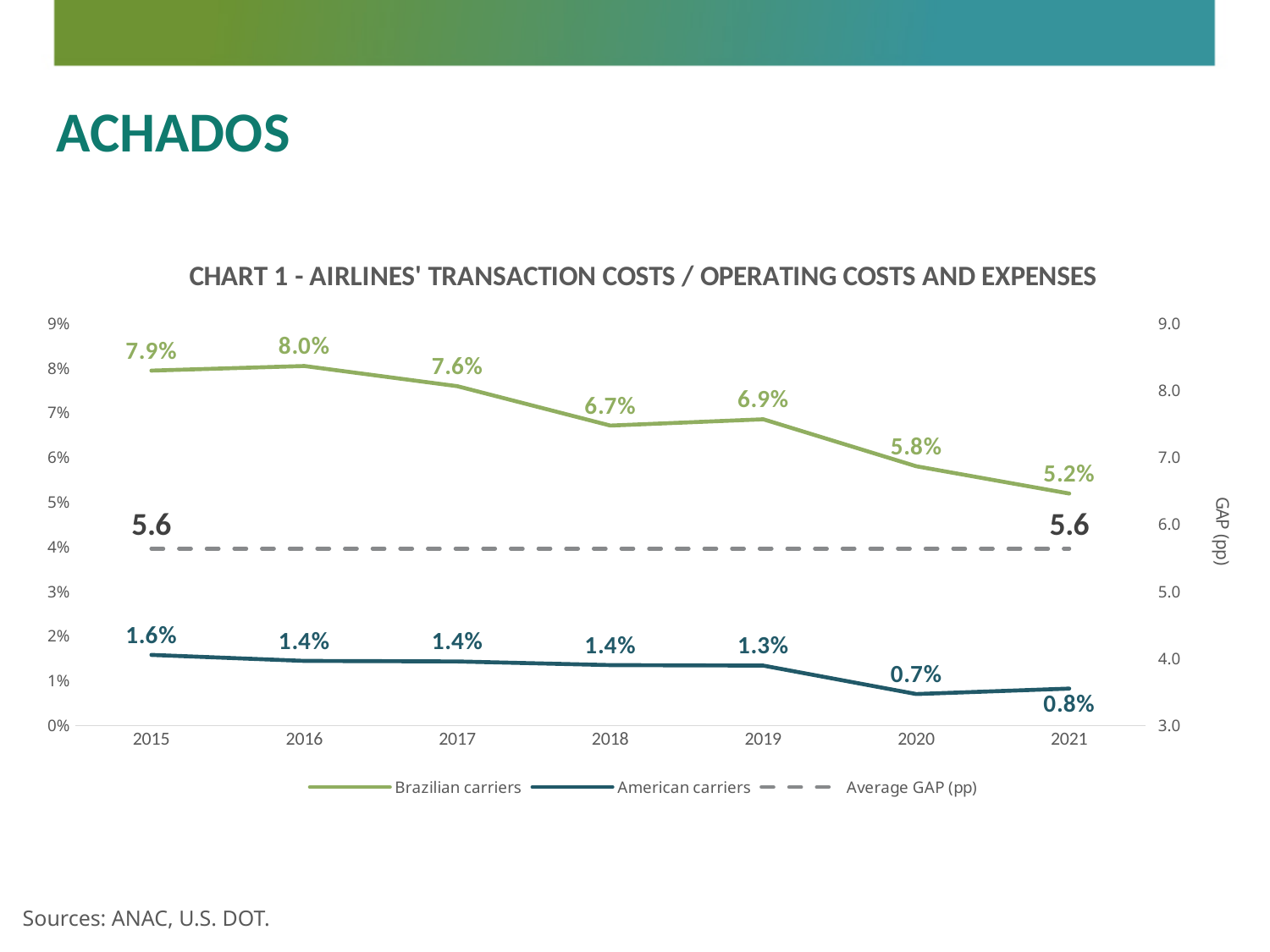
What is the difference between the Brazilian carriers value in 2015 and in 2021? 2.7% What is the value for American carriers in 2020? 0.7% In which year is the Brazilian carriers value highest? 2016 Do the Brazilian carriers values generally rise or fall from 2015 to 2021? Fall What kind of chart is this? Line chart In which year is the American carriers value lowest? 2020 Which is larger in 2019: the Brazilian carriers value or the American carriers value? Brazilian carriers How many years are shown on the x axis? 7 How many series does the legend list? 3 What is the value for Brazilian carriers in 2021? 5.2% What is the value of the Average GAP (pp) line? 5.6 What is the value for Brazilian carriers in 2016? 8.0%